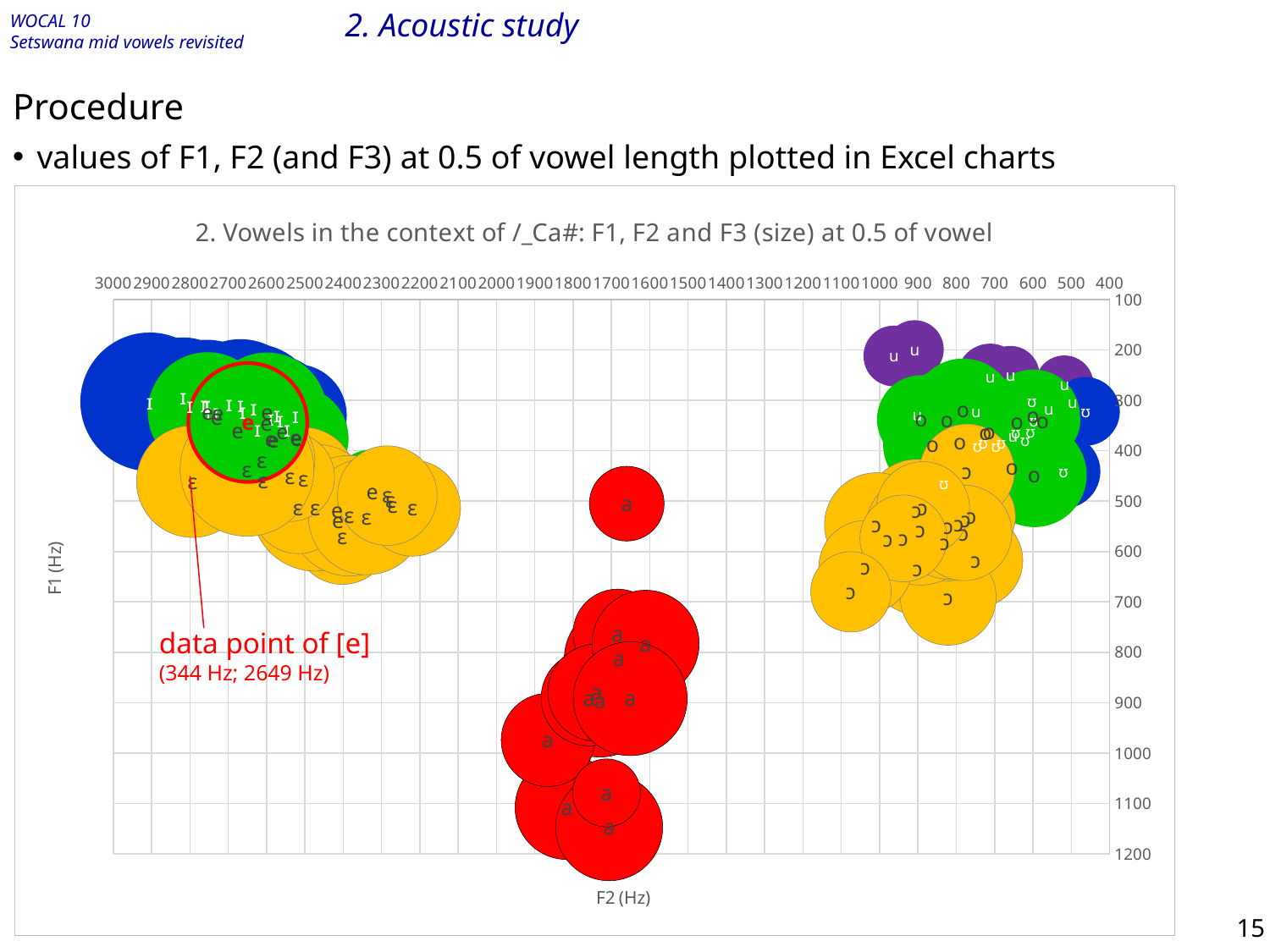
Are the [a] data points plotted at F2 values greater or less than 2000 Hz? less Is the F1 value of the annotated [e] data point greater or less than 400 Hz? less What is the F2 value of the annotated data point of [e]? 2649 Hz What is the F1 value of the annotated data point of [e]? 344 Hz What is the label of the horizontal axis of the chart? F2 (Hz) What is the highest F2 value shown on the horizontal axis of the chart? 3000 What kind of chart is shown on the slide? bubble chart Are the [u] data points plotted at F1 values greater or less than 400 Hz? less What is the highest F1 value shown on the vertical axis of the chart? 1200 What is the title of the chart? 2. Vowels in the context of /_Ca#: F1, F2 and F3 (size) at 0.5 of vowel Which vowel is plotted with the highest F1 values on the chart? a